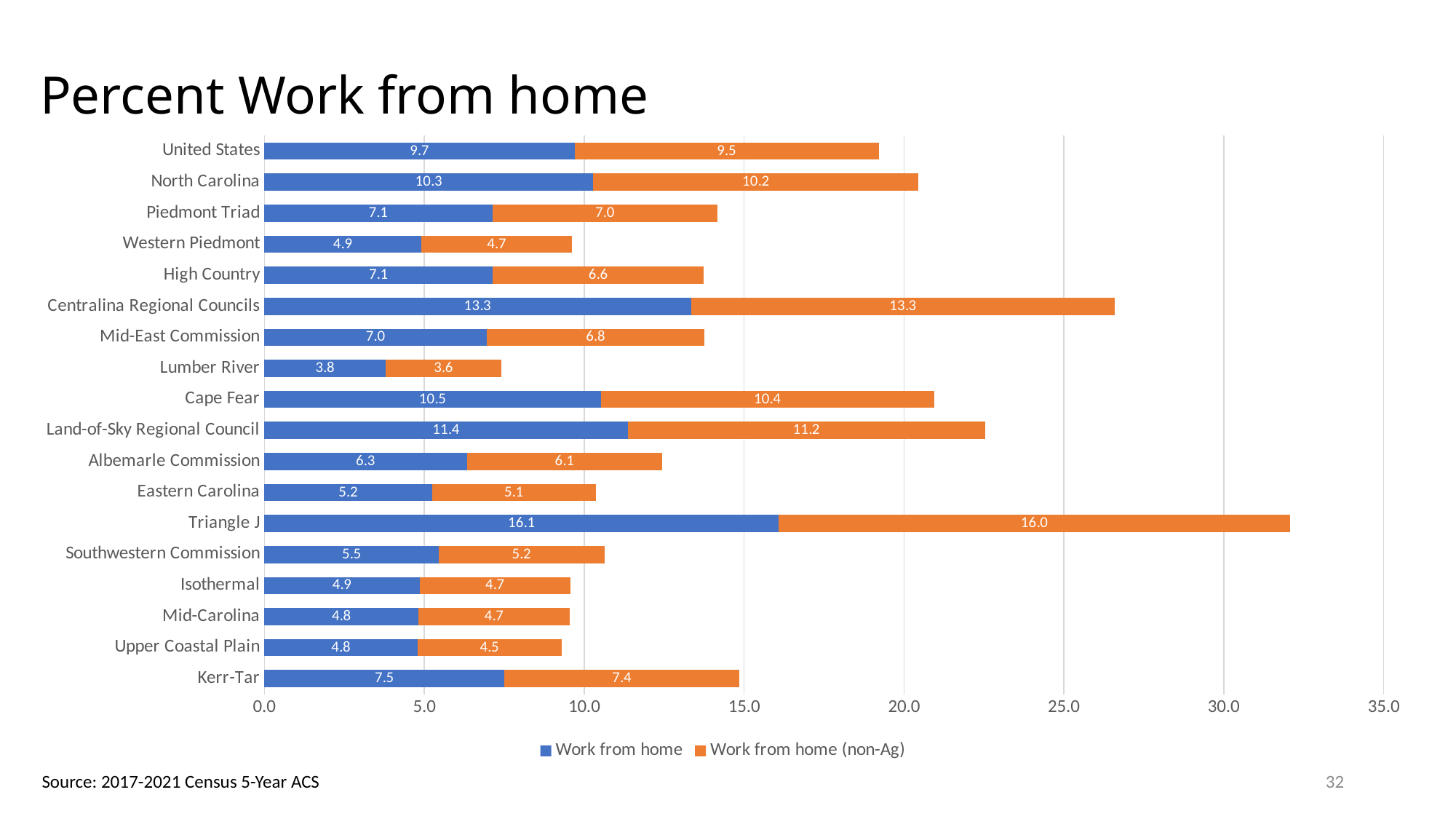
What is the Work from home (non-Ag) value for Centralina Regional Councils? 13.3 What is the Work from home (non-Ag) value for Kerr-Tar? 7.4 What is the difference between the Work from home values for Centralina Regional Councils and Cape Fear? 2.8 Which category has the lowest Work from home (non-Ag) value? Lumber River What is the total of the stacked bar for Triangle J? 32.1 How many categories are shown on the chart? 18 What is the total of the stacked bar for Lumber River? 7.4 Which category has the highest Work from home value? Triangle J Which has a larger Work from home value, North Carolina or the United States? North Carolina What is the Work from home value for North Carolina? 10.3 How many series does the legend list? 2 What kind of chart is shown on the slide? Stacked bar chart